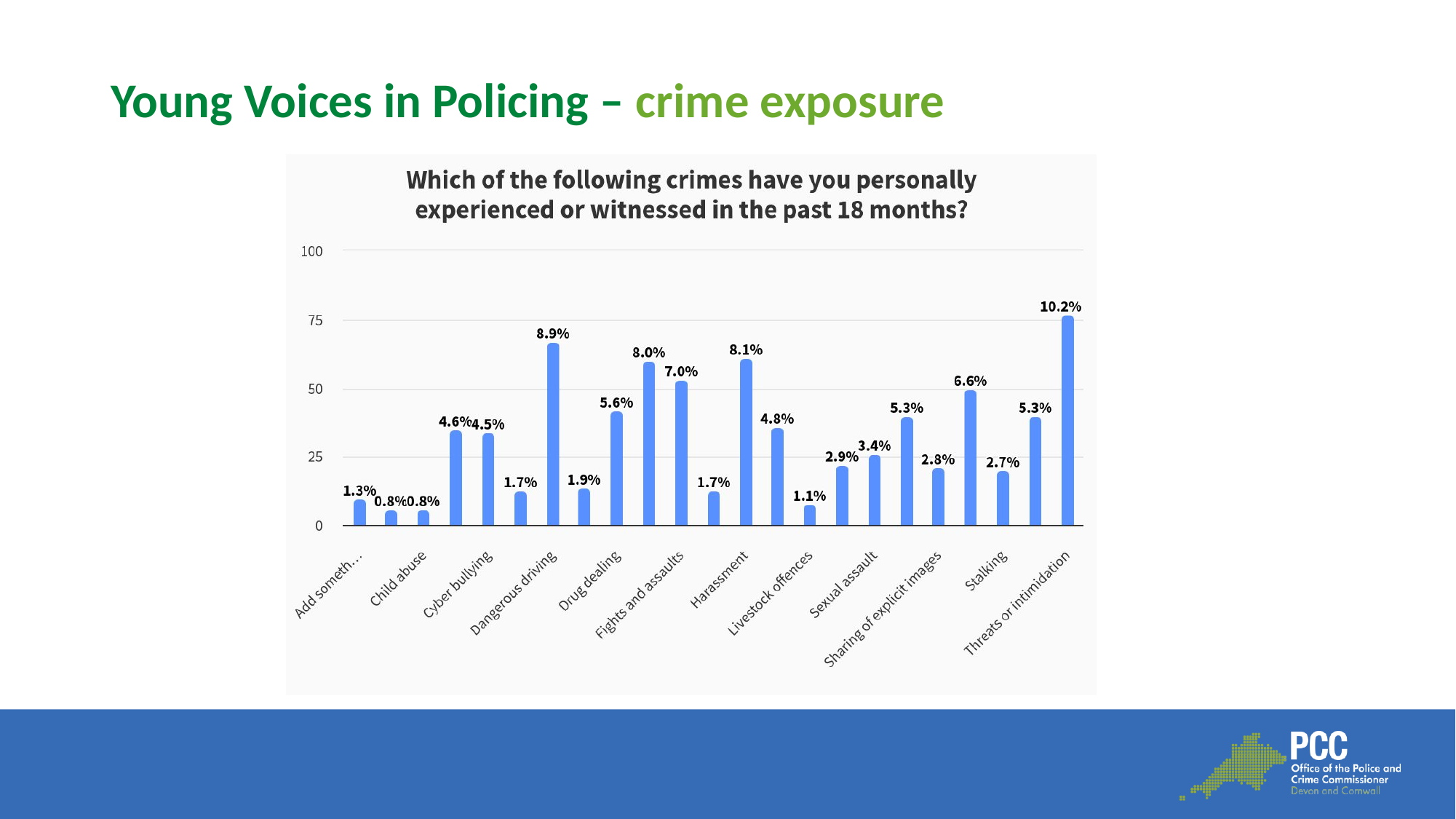
How many bars carry the data label 5.3%? 2 How many bars carry the data label 0.8%? 2 How many category labels are shown along the x axis? 12 What is the title of the chart? Which of the following crimes have you personally experienced or witnessed in the past 18 months? What kind of chart is shown on the slide? Bar chart What is the difference between the highest data label (10.2%) and the lowest data label (0.8%)? 9.4 percentage points What is the second highest data label on the chart? 8.9% What is the difference between the data labels 8.9% and 8.1%? 0.8 percentage points What is the lowest value shown on the chart? 0.8% What is the highest value shown on the chart? 10.2% What is the highest tick value on the vertical axis? 100